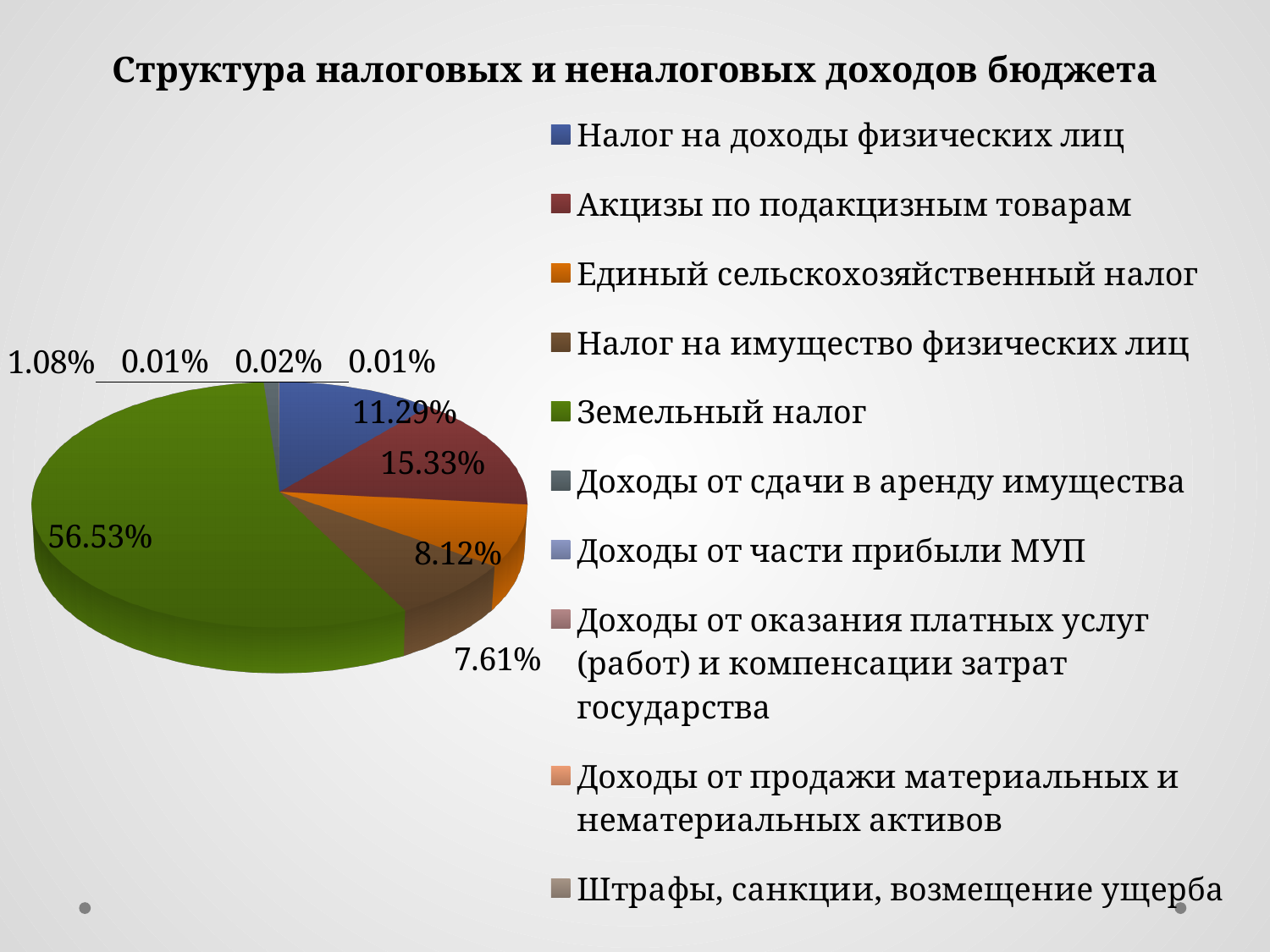
What is the value for Акцизы по подакцизным товарам? 15.33% What is the difference between the shares of Единый сельскохозяйственный налог and Налог на имущество физических лиц? 0.51% What type of chart is shown on the slide? Pie chart What is the value for Единый сельскохозяйственный налог? 8.12% Which is larger: Акцизы по подакцизным товарам or Налог на доходы физических лиц? Акцизы по подакцизным товарам How many entries does the chart legend list? 10 Which category has the largest share of the pie? Земельный налог What is the value for Налог на доходы физических лиц? 11.29% What share of the pie does Земельный налог have? 56.53% What is the title of the chart? Структура налоговых и неналоговых доходов бюджета What is the value for Налог на имущество физических лиц? 7.61% What is the difference between the shares of Акцизы по подакцизным товарам and Налог на доходы физических лиц? 4.04%